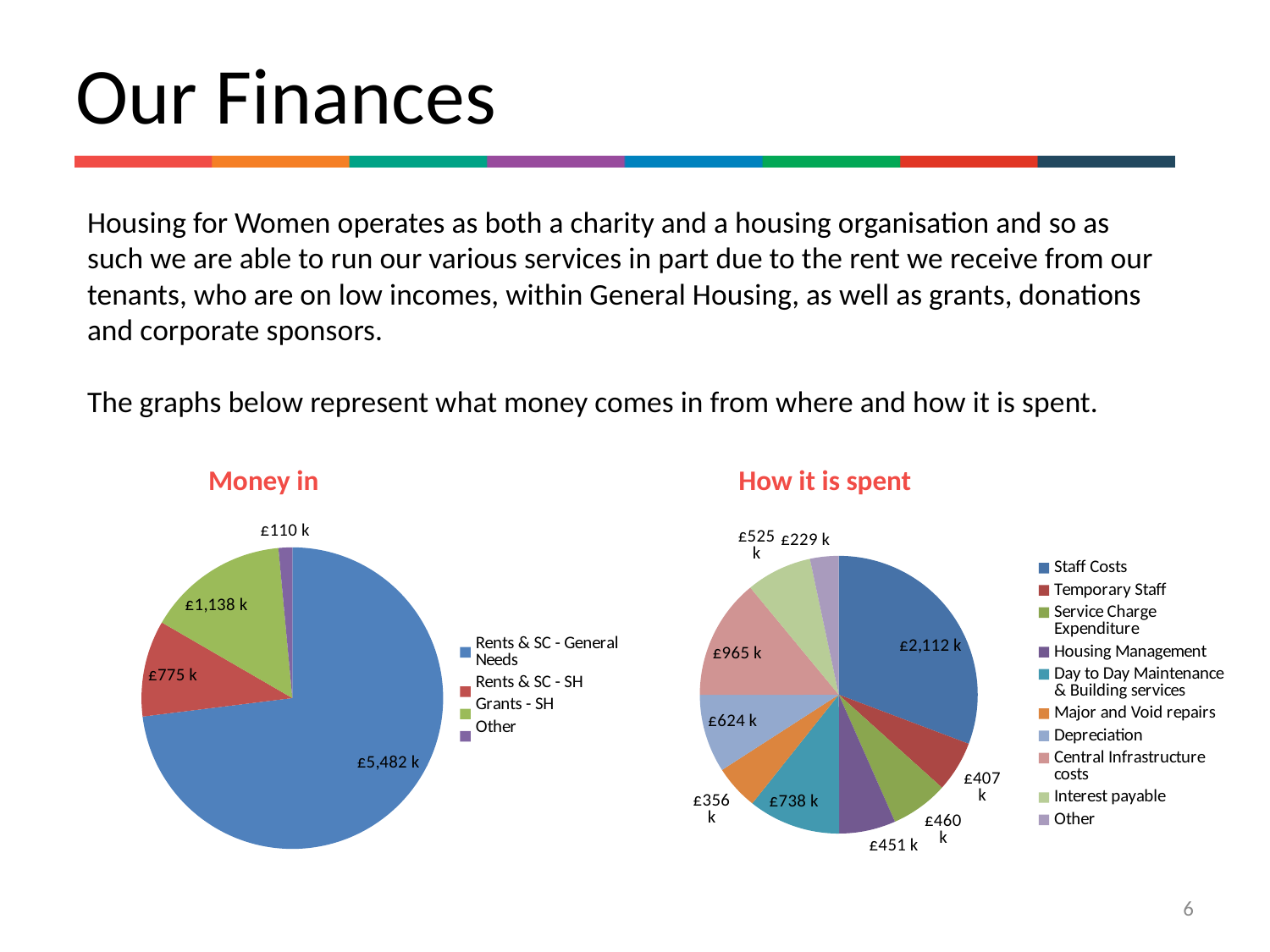
In the "How it is spent" chart, how many categories does the legend list? 10 In the "How it is spent" chart, what is the value for Staff Costs? £2,112 k In the "How it is spent" chart, what is the value for Central Infrastructure costs? £965 k In the "How it is spent" chart, what is the value for Depreciation? £624 k In the "Money in" chart, what is the value for Rents & SC - General Needs? £5,482 k In the "Money in" chart, which category has the smallest value? Other What type of chart is the "How it is spent" chart? Pie chart In the "How it is spent" chart, which is larger: Day to Day Maintenance & Building services or Major and Void repairs? Day to Day Maintenance & Building services In the "Money in" chart, what is the difference between Rents & SC - General Needs and Grants - SH? £4,344 k In the "Money in" chart, what is the value for Grants - SH? £1,138 k In the "How it is spent" chart, which category has the largest value? Staff Costs In the "Money in" chart, how many categories are shown? 4